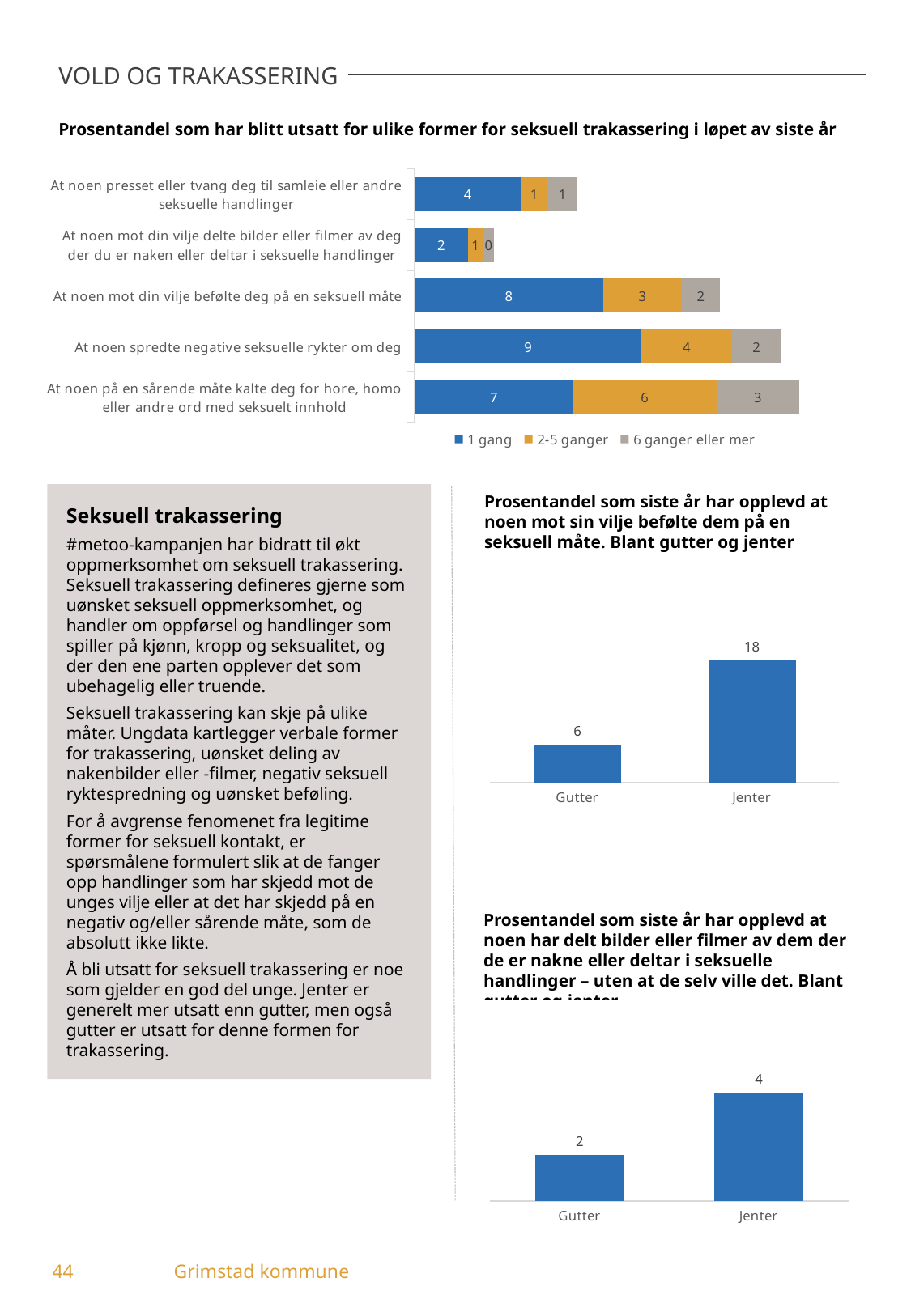
In the bottom chart about 'delt bilder eller filmer', what is the value for Gutter? 2 In the top chart, how many series does the legend list? 3 In the bottom chart about 'delt bilder eller filmer', which is larger, Gutter or Jenter? Jenter In the top chart, what is the '2-5 ganger' value for 'At noen på en sårende måte kalte deg for hore, homo eller andre ord med seksuelt innhold'? 6 In the top chart, what is the difference between the '1 gang' values for 'At noen mot din vilje befølte deg på en seksuell måte' and 'At noen mot din vilje delte bilder eller filmer av deg der du er naken eller deltar i seksuelle handlinger'? 6 In the middle chart 'Prosentandel som siste år har opplevd at noen mot sin vilje befølte dem på en seksuell måte', what is the value for Jenter? 18 In the top chart, which category has the highest '1 gang' value? At noen spredte negative seksuelle rykter om deg In the top chart, what is the total of the stacked bar for 'At noen mot din vilje befølte deg på en seksuell måte'? 13 What type of chart is the top chart on the slide? Stacked bar chart In the middle chart about 'befølte dem på en seksuell måte', what is the difference between Jenter and Gutter? 12 In the top chart, how many categories are shown? 5 In the top chart 'Prosentandel som har blitt utsatt for ulike former for seksuell trakassering i løpet av siste år', what is the '1 gang' value for 'At noen spredte negative seksuelle rykter om deg'? 9